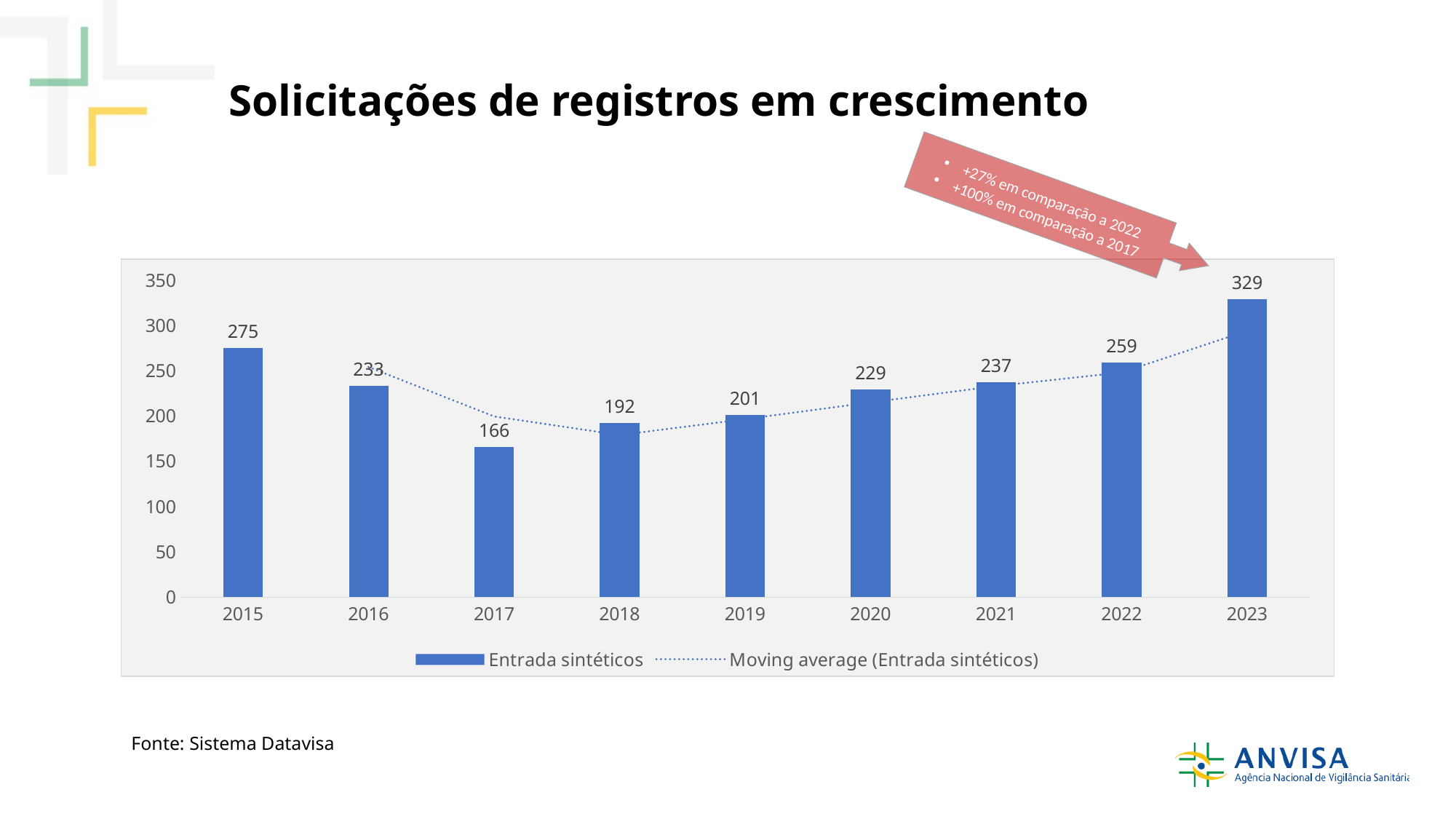
What kind of chart is shown? bar chart Which year has the lowest value? 2017 How many series does the legend list? 2 How many years are shown on the x axis? 9 Which year has the highest value? 2023 Do the values rise or fall from 2017 to 2023? rise What is the difference between the values for 2023 and 2022? 70 Which is larger, the value for 2015 or the value for 2022? 2015 What is the value for 2019? 201 What is the value for 2017? 166 What is the difference between the values for 2015 and 2016? 42 What is the value for 2023? 329